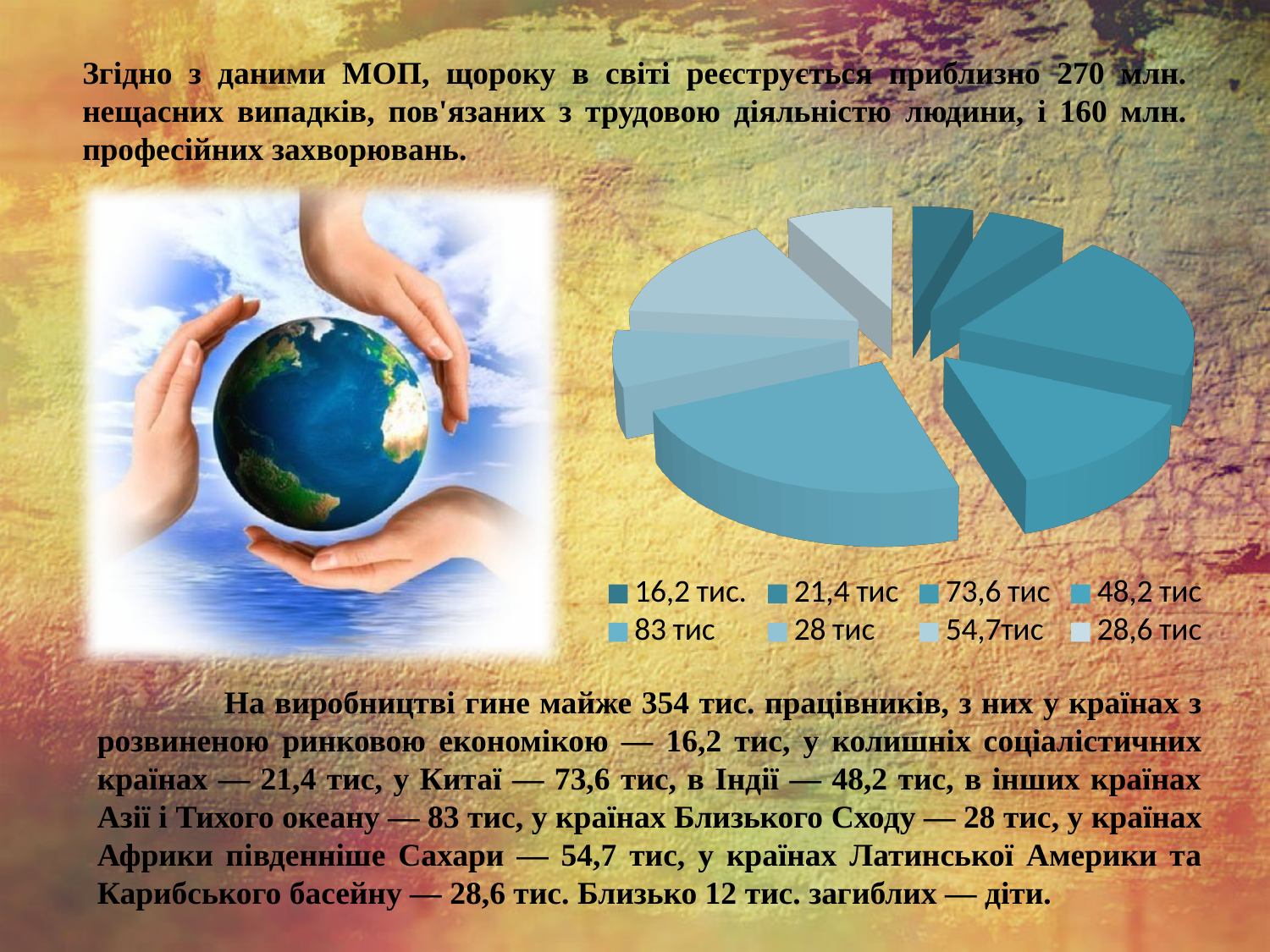
What kind of chart is shown on the slide? pie chart Which legend entry of the pie chart represents the smallest value? 16,2 тис. What is the difference between the largest legend value (83 тис) and the smallest legend value (16,2 тис.) in the pie chart? 66,8 тис Which is larger among the pie chart's legend values, 73,6 тис or 54,7тис? 73,6 тис How many entries does the legend of the pie chart list? 8 Which legend entry of the pie chart represents the largest value? 83 тис What is the last entry listed in the pie chart's legend? 28,6 тис What is the difference between the legend values 73,6 тис and 48,2 тис in the pie chart? 25,4 тис Which is larger among the pie chart's legend values, 28 тис or 28,6 тис? 28,6 тис What is the first entry listed in the pie chart's legend? 16,2 тис. How many slices does the pie chart have? 8